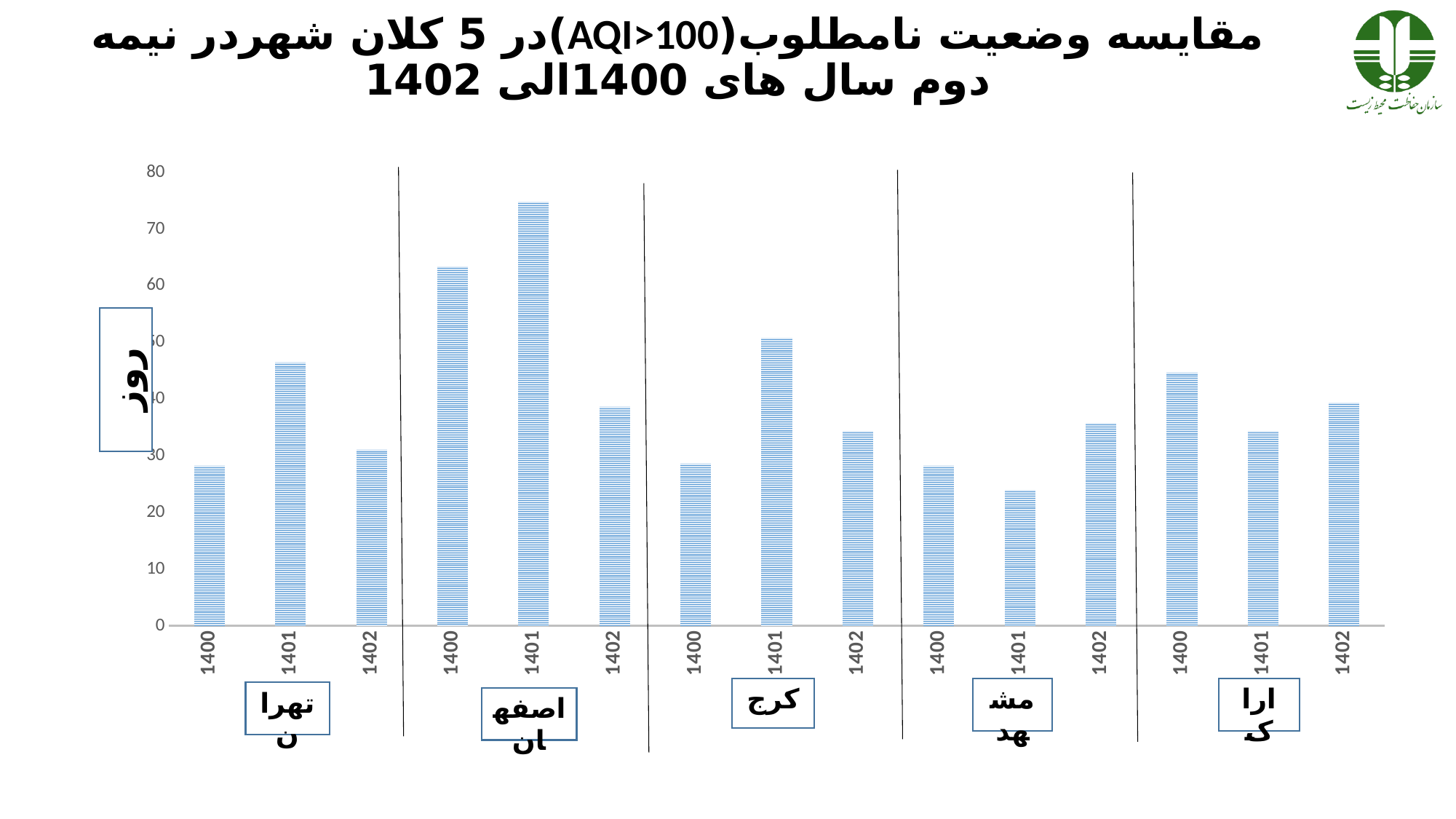
Within the مشهد group, do the values rise or fall from 1400 to 1401? fall What kind of chart is shown on the slide? bar chart Which is larger, the value for تهران in 1401 or the value for تهران in 1402? تهران 1401 What is the label shown on the vertical axis of the chart? روز How many bars are plotted in the chart? 15 Is the value for تهران in 1400 greater or less than 30? less Which bar is the lowest in the chart? مشهد 1401 How many city groups are shown along the x axis of the chart? 5 Is the value for اراک in 1400 greater or less than 40? greater Which bar is the highest in the chart? اصفهان 1401 Is the value for اصفهان in 1401 greater or less than 70? greater